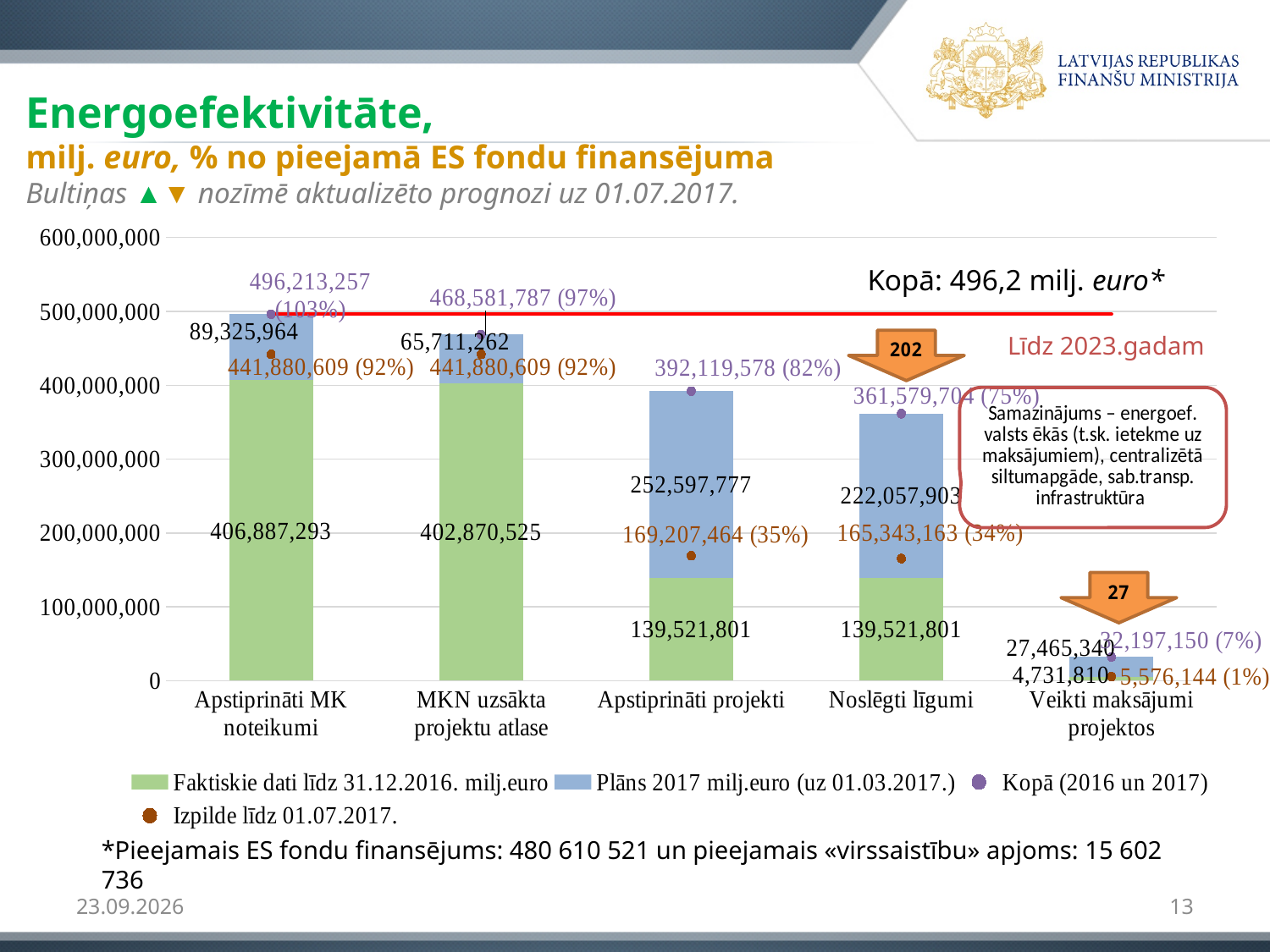
What is the total of the stacked bar for 'Apstiprināti MK noteikumi'? 496,213,257 What is the value of 'Faktiskie dati līdz 31.12.2016. milj.euro' for 'Apstiprināti MK noteikumi'? 406,887,293 Which category has the lowest 'Plāns 2017 milj.euro (uz 01.03.2017.)' value? Veikti maksājumi projektos Which is larger: the 'Plāns 2017' value for 'Apstiprināti MK noteikumi' or for 'MKN uzsākta projektu atlase'? Apstiprināti MK noteikumi Is the 'Kopā (2016 un 2017)' value for 'Noslēgti līgumi' greater or less than 400,000,000? less What is the 'Izpilde līdz 01.07.2017.' value for 'Noslēgti līgumi'? 165,343,163 (34%) What is the difference between the 'Plāns 2017' values for 'Apstiprināti projekti' and 'Noslēgti līgumi'? 30,539,874 How many series does the chart legend list? 4 What type of chart is shown on the slide? stacked bar chart with line and point markers (combination chart) Which category has the highest 'Faktiskie dati līdz 31.12.2016. milj.euro' value? Apstiprināti MK noteikumi What is the value of 'Plāns 2017 milj.euro (uz 01.03.2017.)' for 'Apstiprināti projekti'? 252,597,777 How many categories are shown on the x axis of the chart? 5